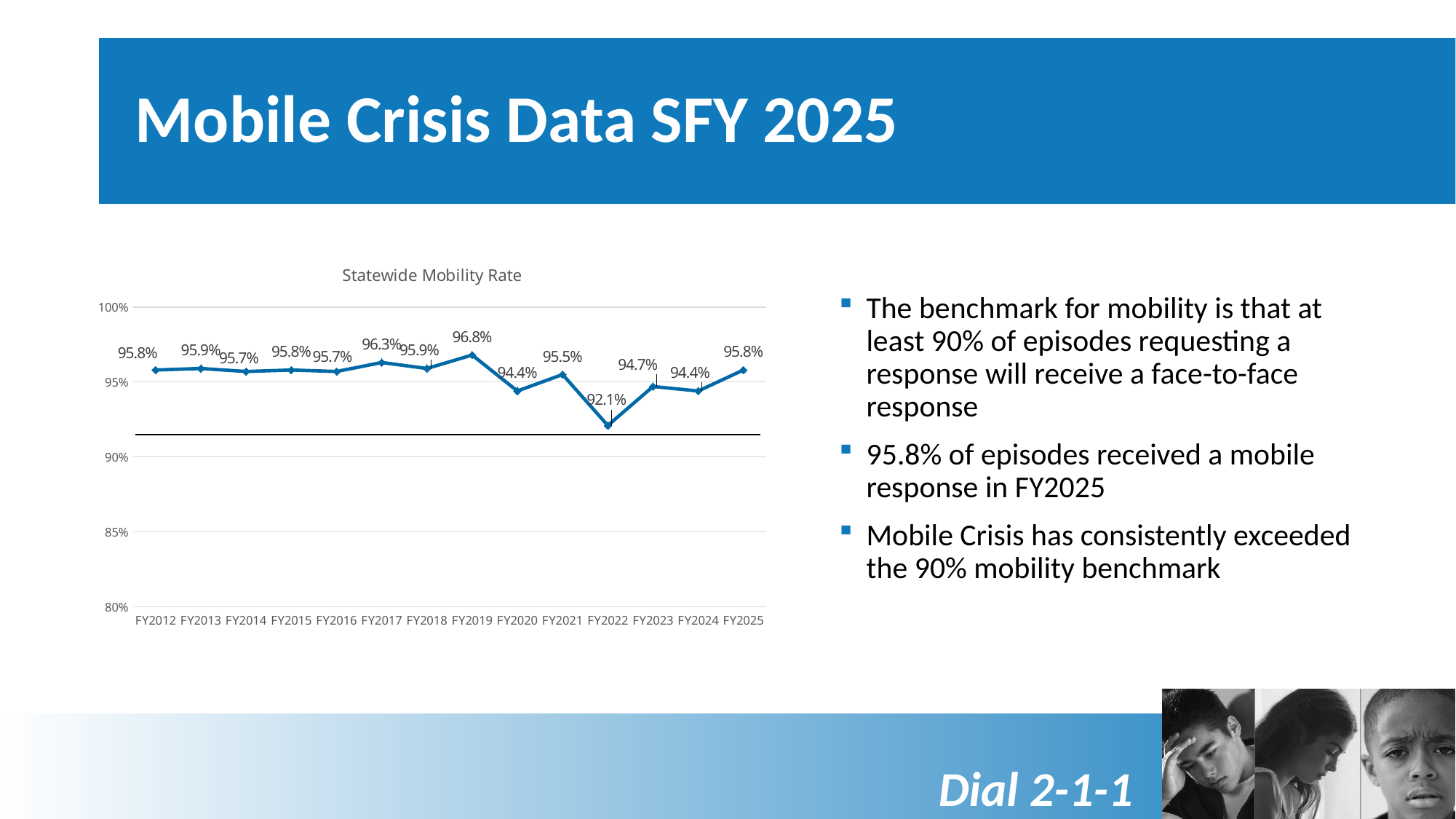
Which fiscal year has the highest Statewide Mobility Rate? FY2019 What is the Statewide Mobility Rate for FY2025? 95.8% Which fiscal year has the lowest Statewide Mobility Rate? FY2022 Does the Statewide Mobility Rate rise or fall from FY2022 to FY2023? rise What is the title of the chart? Statewide Mobility Rate What kind of chart is shown on the slide? line chart What is the difference between the Statewide Mobility Rate in FY2019 and FY2022? 4.7% Which is higher, the Statewide Mobility Rate in FY2021 or FY2022? FY2021 What is the Statewide Mobility Rate for FY2022? 92.1% Is the Statewide Mobility Rate for FY2022 greater or less than 95%? less What is the Statewide Mobility Rate for FY2019? 96.8% How many fiscal years are plotted on the x axis of the chart? 14